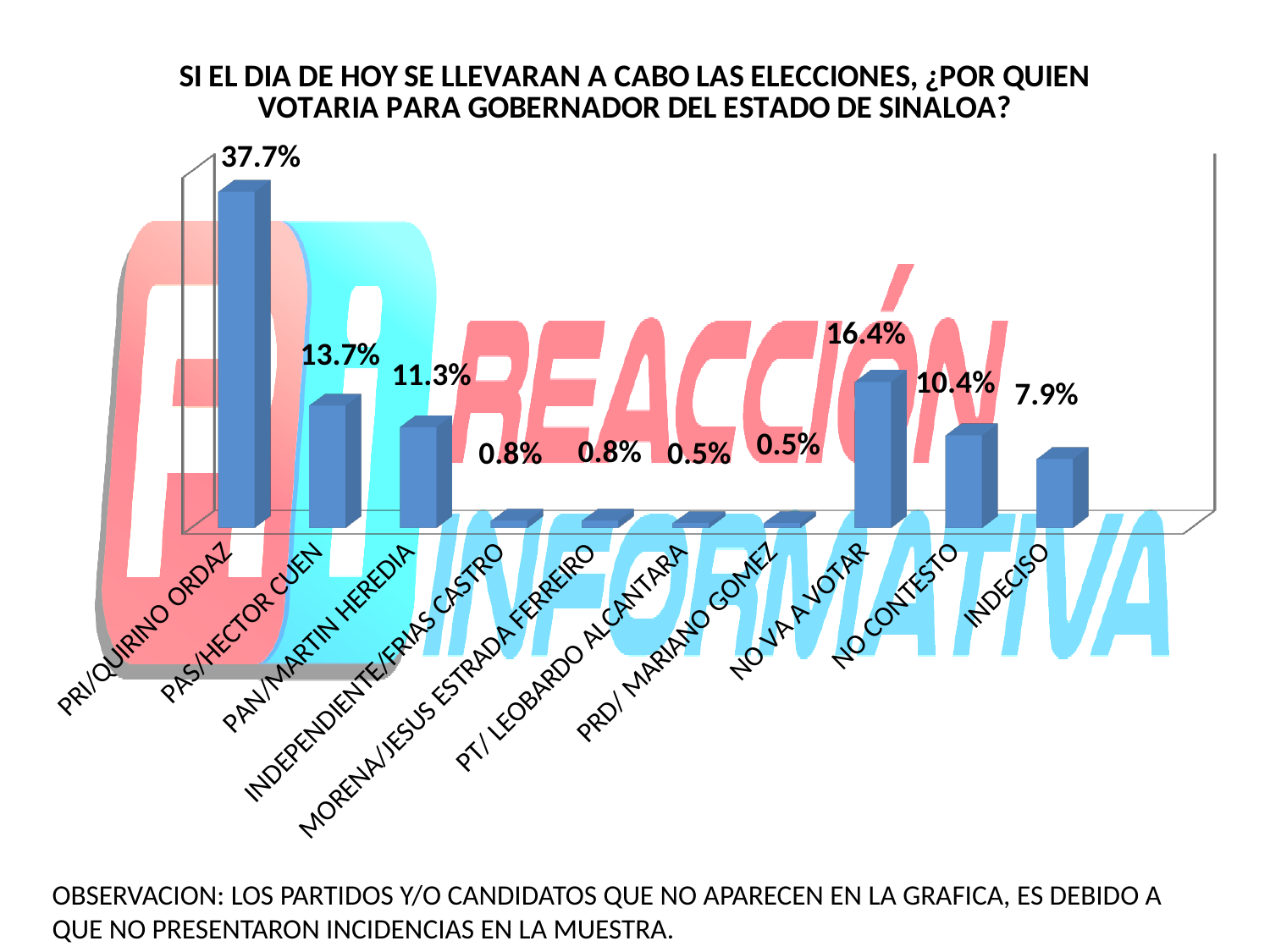
What percentage is shown for PT/ LEOBARDO ALCANTARA? 0.5% What percentage is shown for INDECISO? 7.9% What percentage is shown for NO VA A VOTAR? 16.4% Which category has the highest value? PRI/QUIRINO ORDAZ What is the difference between the values for NO VA A VOTAR and NO CONTESTO? 6.0% What is the difference between the values for PRI/QUIRINO ORDAZ and PAS/HECTOR CUEN? 24.0% What percentage is shown for PRI/QUIRINO ORDAZ? 37.7% Which is larger, the value for PAS/HECTOR CUEN or the value for NO VA A VOTAR? NO VA A VOTAR What percentage is shown for PAN/MARTIN HEREDIA? 11.3% What is the title of the chart? SI EL DIA DE HOY SE LLEVARAN A CABO LAS ELECCIONES, ¿POR QUIEN VOTARIA PARA GOBERNADOR DEL ESTADO DE SINALOA? How many categories are shown on the chart? 10 What kind of chart is shown on the slide? Bar chart